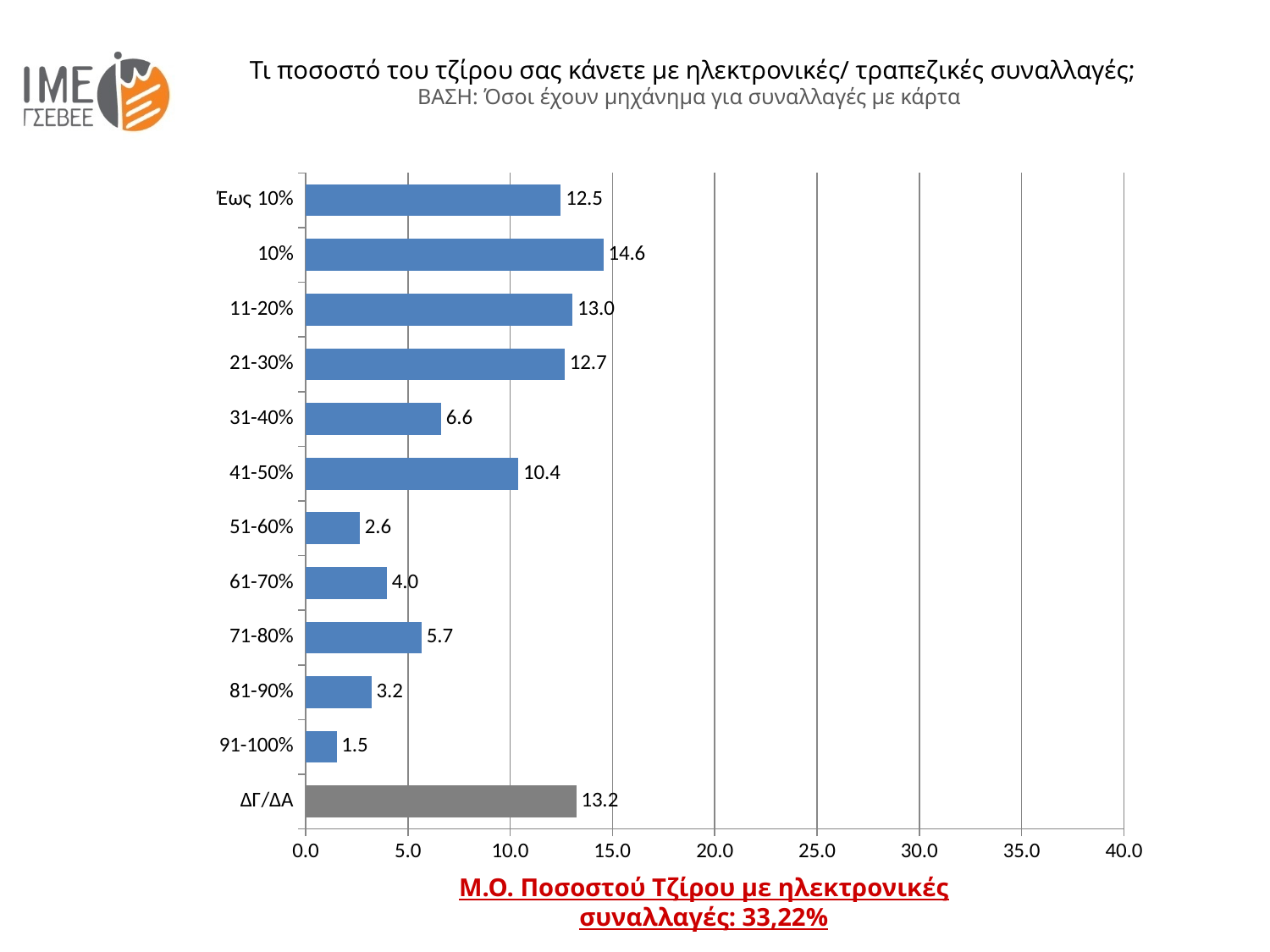
What average percentage of turnover with electronic transactions is stated below the chart? 33,22% What is the value for the 10% category? 14.6 Is the value for Έως 10% greater or less than 10.0? greater What kind of chart is shown on the slide? bar chart What is the value for 51-60%? 2.6 Which is larger, the value for 41-50% or the value for 71-80%? 41-50% What is the difference between the values for 11-20% and 21-30%? 0.3 What is the value for the 31-40% category? 6.6 What is the value for ΔΓ/ΔΑ? 13.2 How many categories are shown on the chart? 12 Which category has the highest value? 10% Which category has the lowest value? 91-100%